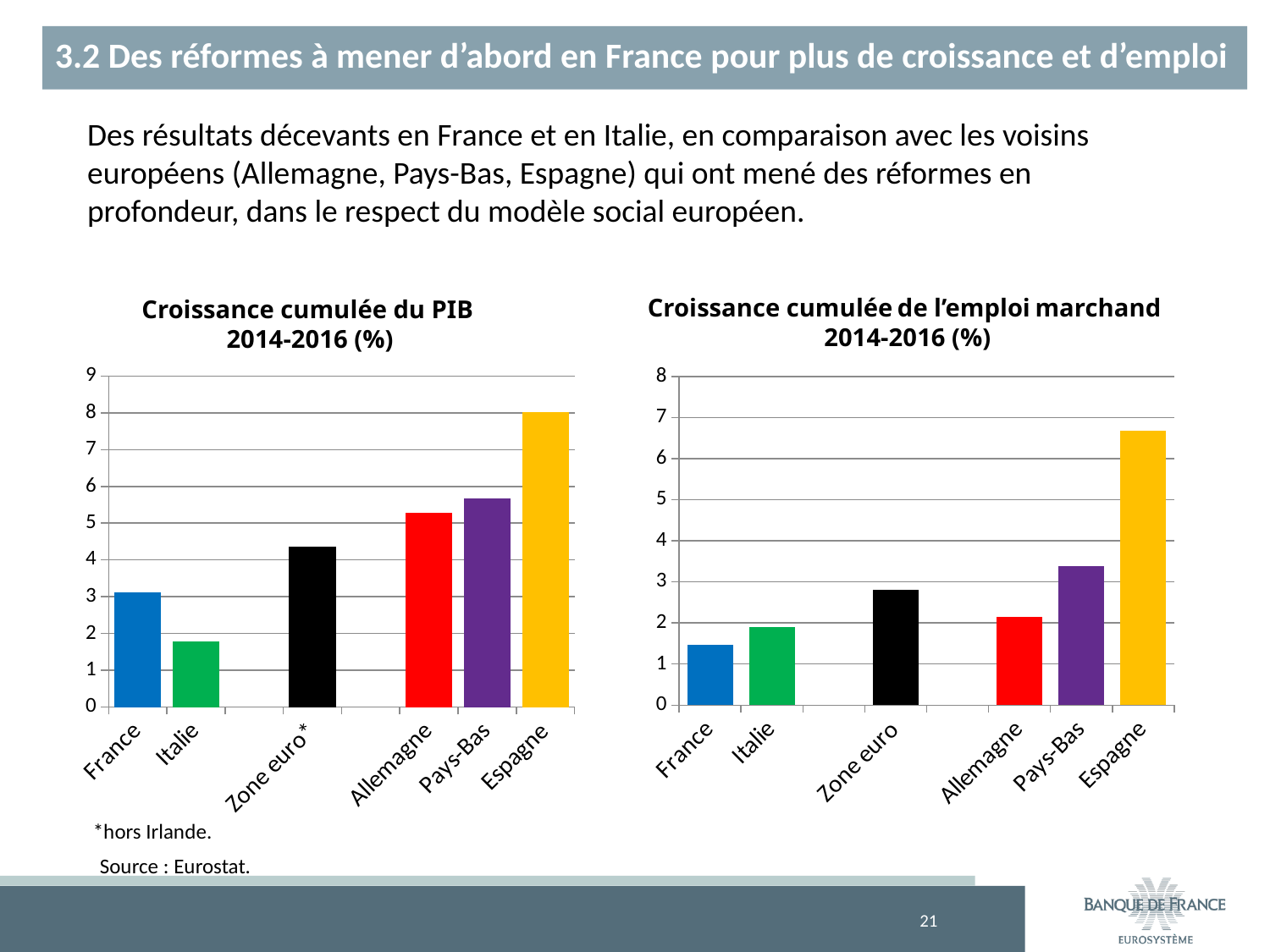
In the chart titled "Croissance cumulée du PIB 2014-2016 (%)", which category has the lowest value? Italie In the chart titled "Croissance cumulée de l'emploi marchand 2014-2016 (%)", which is larger, the value for Zone euro or the value for Allemagne? Zone euro How many categories are shown in the chart titled "Croissance cumulée du PIB 2014-2016 (%)"? 6 What is the source cited below the charts on the slide? Eurostat In the chart titled "Croissance cumulée du PIB 2014-2016 (%)", which category has the highest value? Espagne In the chart titled "Croissance cumulée du PIB 2014-2016 (%)", is the value for France greater or less than 2? greater In the chart titled "Croissance cumulée de l'emploi marchand 2014-2016 (%)", which category has the lowest value? France In the chart titled "Croissance cumulée du PIB 2014-2016 (%)", is the value for Allemagne greater or less than 6? less In the chart titled "Croissance cumulée du PIB 2014-2016 (%)", which is larger, the value for Pays-Bas or the value for Zone euro*? Pays-Bas In the chart titled "Croissance cumulée de l'emploi marchand 2014-2016 (%)", is the value for Espagne greater or less than 6? greater In the chart titled "Croissance cumulée de l'emploi marchand 2014-2016 (%)", which category has the highest value? Espagne What kind of chart is the chart titled "Croissance cumulée de l'emploi marchand 2014-2016 (%)"? Bar chart